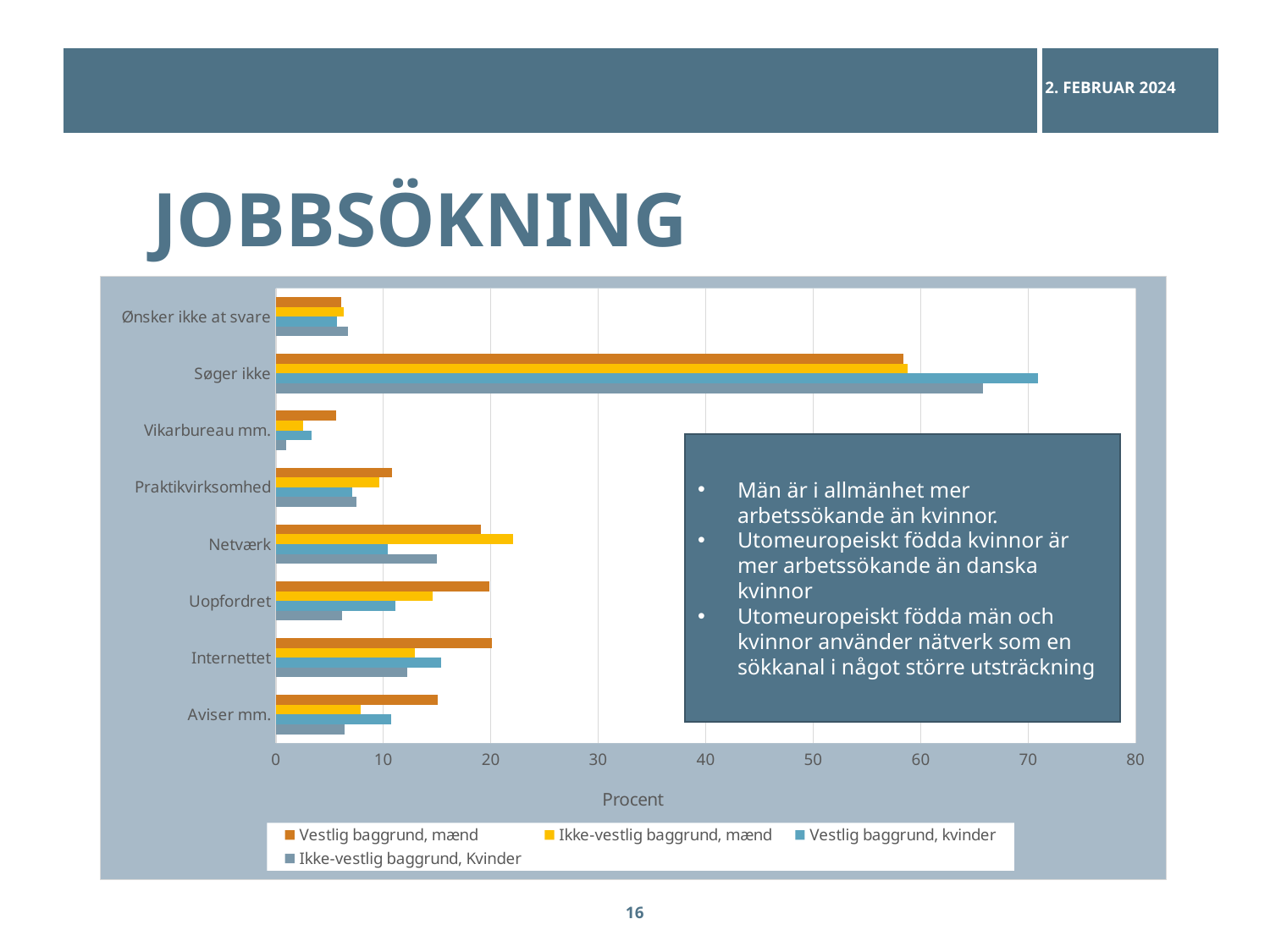
What kind of chart is shown on the slide? bar chart For 'Søger ikke', which is larger: 'Vestlig baggrund, kvinder' or 'Ikke-vestlig baggrund, Kvinder'? Vestlig baggrund, kvinder Is the value for 'Netværk' in the 'Ikke-vestlig baggrund, mænd' series greater or less than 20? greater How many categories are shown on the vertical axis of the chart? 8 Is the value for 'Søger ikke' in the 'Vestlig baggrund, kvinder' series greater or less than 60? greater How many series does the chart's legend list? 4 What is the title of the horizontal axis of the chart? Procent Which category has the highest value for the 'Vestlig baggrund, mænd' series? Søger ikke Is the value for 'Uopfordret' in the 'Ikke-vestlig baggrund, Kvinder' series greater or less than 10? less For 'Netværk', which is larger: 'Ikke-vestlig baggrund, mænd' or 'Vestlig baggrund, kvinder'? Ikke-vestlig baggrund, mænd Which category has the lowest value for the 'Ikke-vestlig baggrund, Kvinder' series? Vikarbureau mm. Which series has the highest value for the 'Søger ikke' category? Vestlig baggrund, kvinder